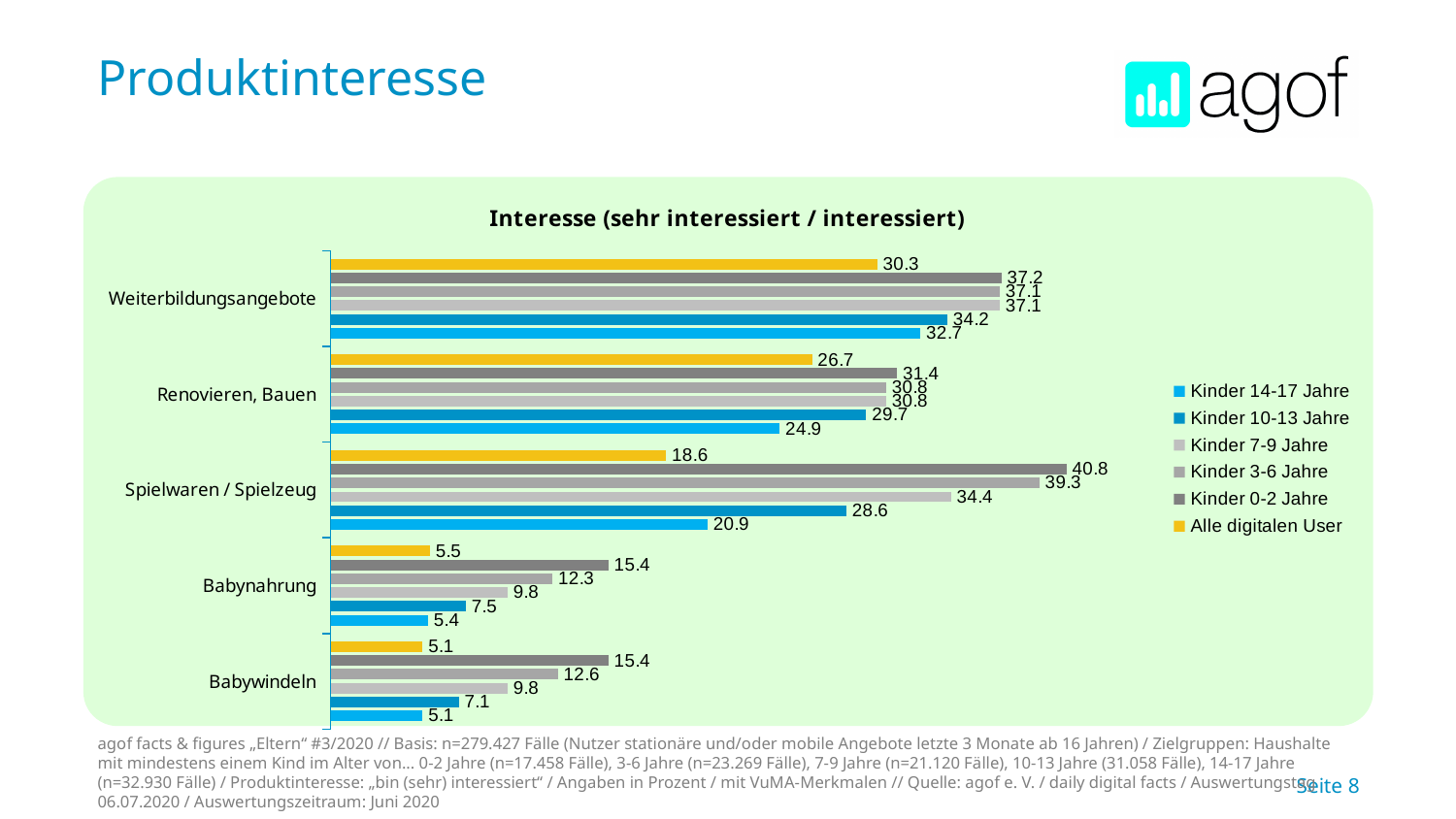
What is the value for Kinder 14-17 Jahre in the Renovieren, Bauen category? 24.9 Which category has the highest value for Alle digitalen User? Weiterbildungsangebote How many series does the legend list? 6 Which category has the lowest value for Kinder 10-13 Jahre? Babywindeln What is the title of the chart? Interesse (sehr interessiert / interessiert) What is the difference between the Kinder 0-2 Jahre value and the Alle digitalen User value in the Spielwaren / Spielzeug category? 22.2 What type of chart is shown on the slide? Bar chart What is the value for Kinder 0-2 Jahre in the Spielwaren / Spielzeug category? 40.8 In the Babynahrung category, which is larger: the value for Kinder 3-6 Jahre or the value for Kinder 10-13 Jahre? Kinder 3-6 Jahre What is the value for Alle digitalen User in the Weiterbildungsangebote category? 30.3 What is the value for Kinder 7-9 Jahre in the Babynahrung category? 9.8 How many categories are shown on the chart? 5